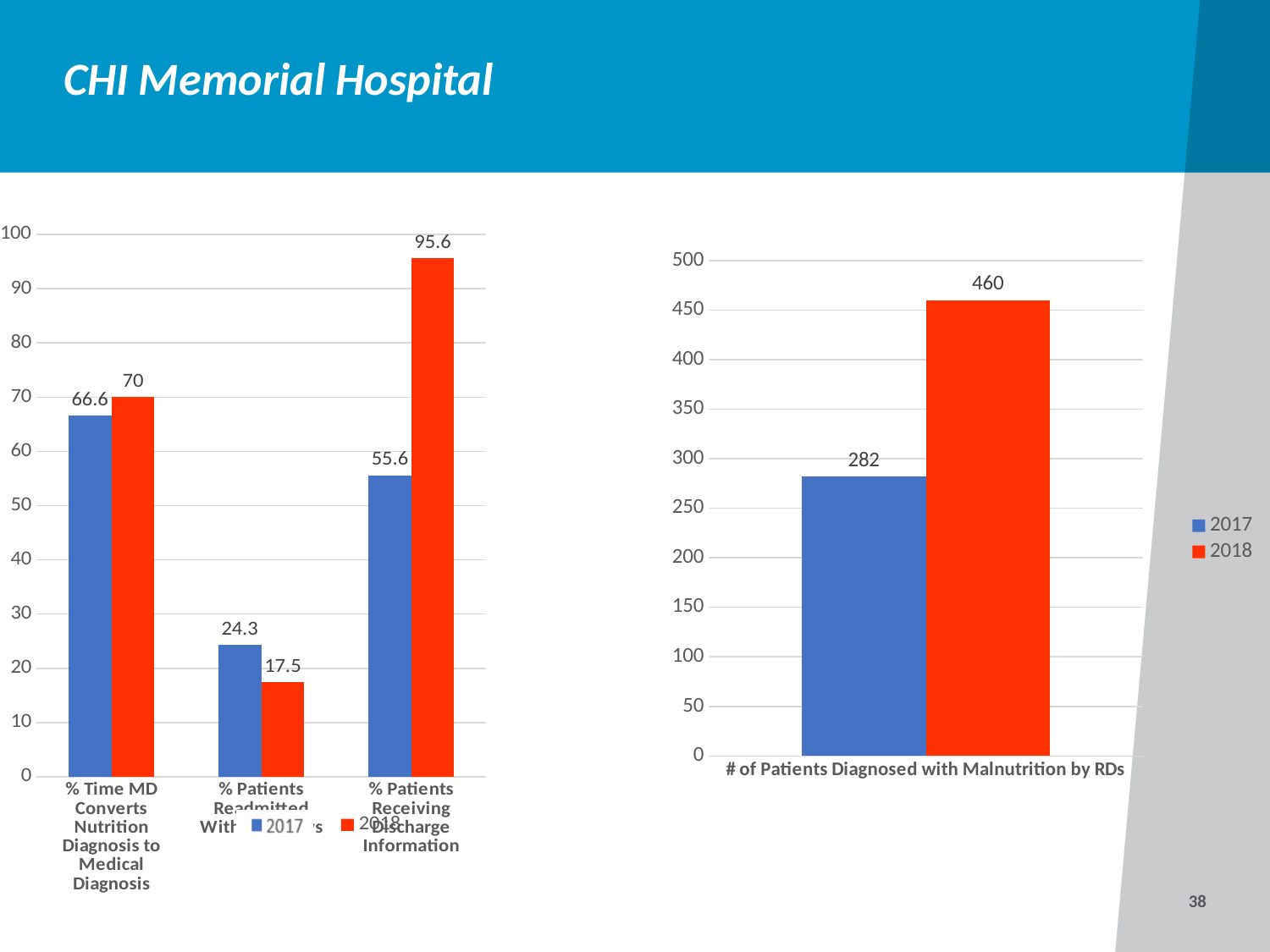
How many series does the legend of the right chart list? 2 What type of chart is the right chart? bar chart In the left chart, what is the 2017 value for % Time MD Converts Nutrition Diagnosis to Medical Diagnosis? 66.6 How many categories are shown on the x axis of the left chart? 3 In the left chart, which category has the lowest 2017 value? % Patients Readmitted (middle category) In the left chart, what is the 2018 value for % Patients Receiving Discharge Information? 95.6 In the left chart, which category has the highest 2018 value? % Patients Receiving Discharge Information In the right chart, what is the 2018 value for # of Patients Diagnosed with Malnutrition by RDs? 460 In the left chart, what is the difference between the 2018 and 2017 values for % Patients Receiving Discharge Information? 40 In the left chart, is the 2017 value for % Patients Receiving Discharge Information larger or smaller than the 2018 value? smaller In the right chart, what is the difference between the 2018 and 2017 values? 178 In the right chart, what is the 2017 value for # of Patients Diagnosed with Malnutrition by RDs? 282